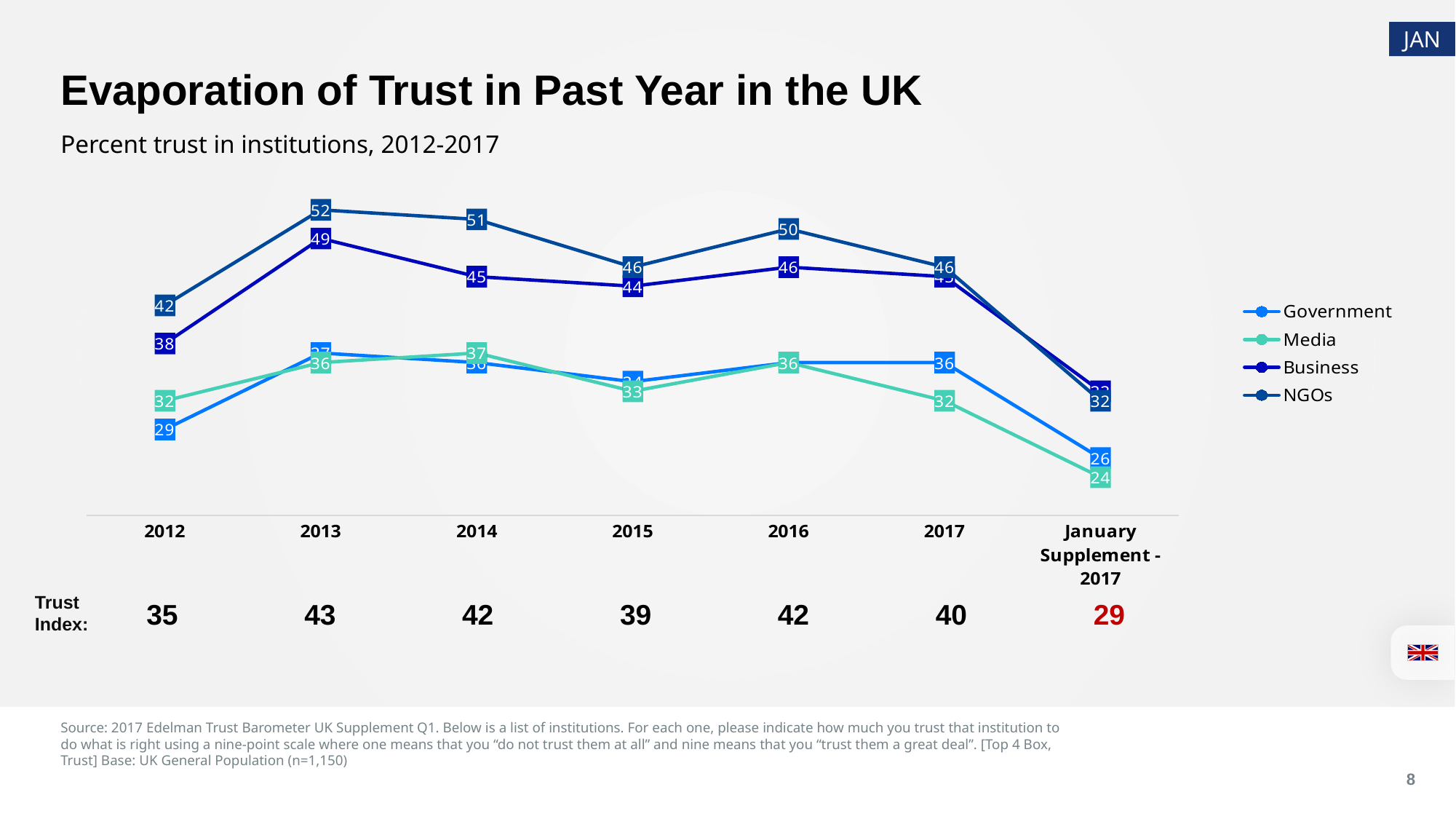
In 2014, which is larger: the NGOs value or the Business value? NGOs What is the value for Business in 2015? 44 How many time points are shown on the x axis? 7 What is the difference between the NGOs value and the Business value in 2013? 3 Which series has the lowest value at the January Supplement - 2017 point? Media What is the value for NGOs in 2013? 52 What is the value for Media at the January Supplement - 2017 point? 24 What kind of chart is shown on the slide? Line chart By how much did the Government value fall from 2017 to the January Supplement - 2017? 10 What is the value for Government in 2012? 29 In which year does the NGOs series reach its highest value? 2013 How many series does the legend list? 4